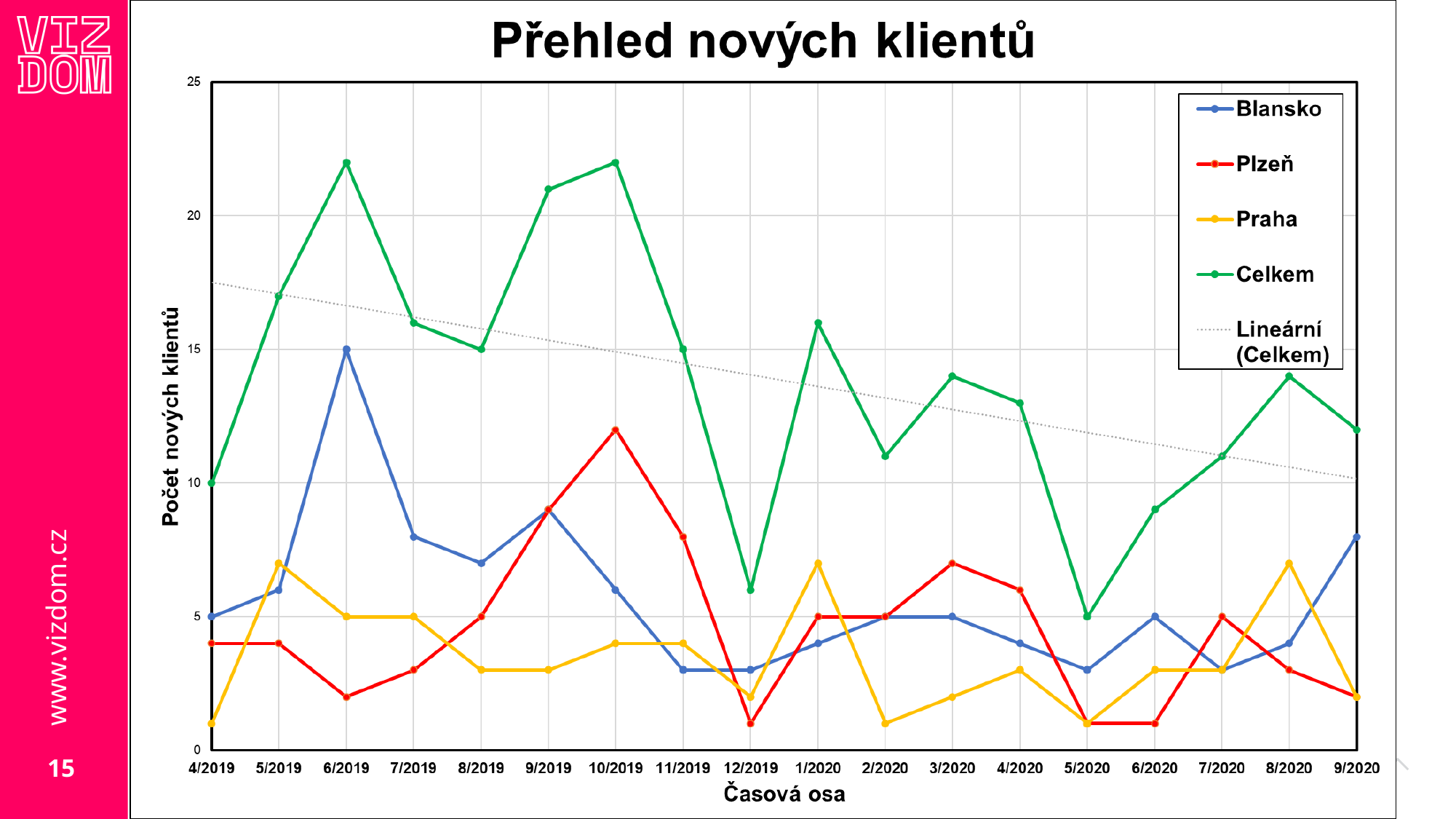
In which period does the Blansko series reach its highest value? 6/2019 What kind of chart is shown on the slide? line chart Which is larger in 10/2019, the value for Plzeň or the value for Blansko? Plzeň Is the value for Celkem in 6/2019 greater or less than 20? greater What is the value for Celkem in 4/2019? 10 In which period does the Celkem series reach its lowest value? 5/2020 What is the value for Celkem in 11/2019? 15 How many entries does the legend list? 5 What is the value for Blansko in 6/2019? 15 How many time periods are shown on the x axis? 18 Does the dotted linear trend line for Celkem rise or fall along the x axis? fall What is the title of the chart? Přehled nových klientů